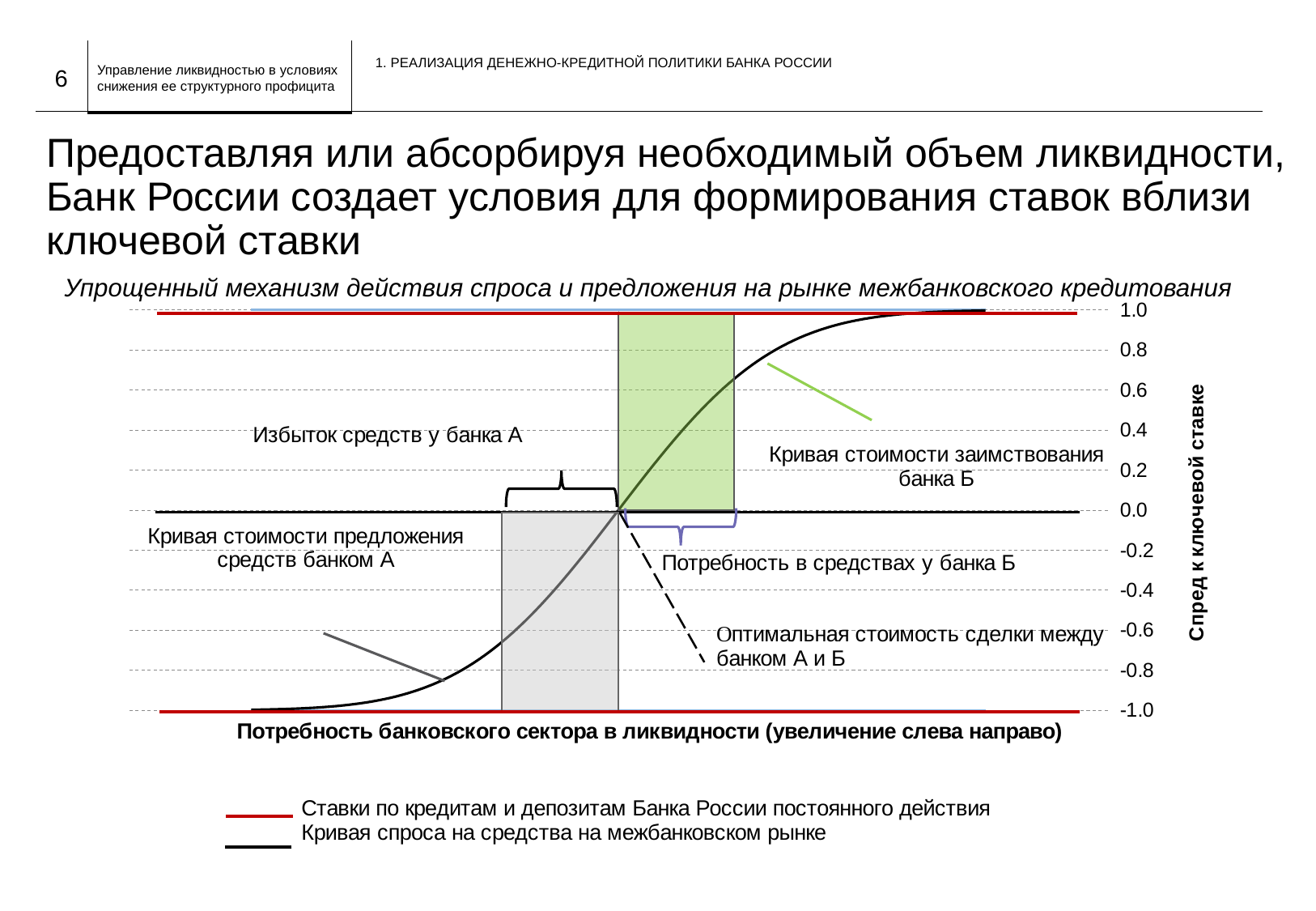
What is the lowest value shown on the vertical axis? -1.0 How many entries does the legend below the chart list? 2 What kind of chart is shown on the slide? line chart Does the black demand curve (Кривая спроса на средства на межбанковском рынке) rise or fall from left to right? rise How many tick values are labelled on the vertical axis? 11 At what value on the vertical axis does the upper red line (Ставки по кредитам и депозитам Банка России постоянного действия) lie? 1.0 What is the highest value shown on the vertical axis? 1.0 At what value on the vertical axis does the lower red line (Ставки по кредитам и депозитам Банка России постоянного действия) lie? -1.0 What is the title of the chart? Упрощенный механизм действия спроса и предложения на рынке межбанковского кредитования At the far left end of the chart, is the black demand curve greater or less than -0.8? less What is the title of the vertical axis? Спред к ключевой ставке At the far right end of the chart, is the black demand curve greater or less than 0.8? greater